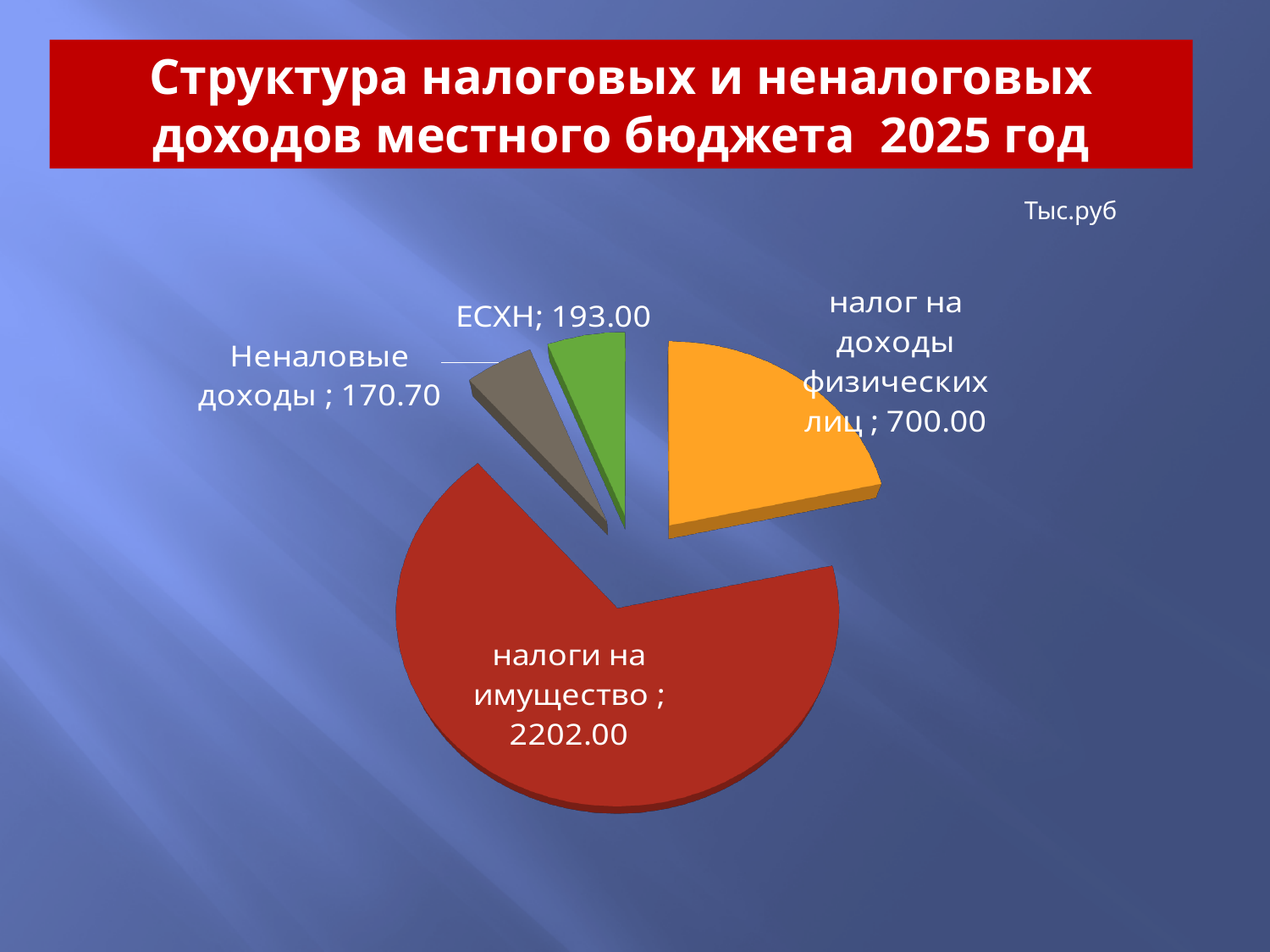
What is the value shown for Неналовые доходы? 170.70 Which category has the largest slice of the pie? налоги на имущество How many slices does the pie chart have? 4 What unit is indicated for the chart values? Тыс.руб What is the difference between ЕСХН and Неналовые доходы? 22.30 Which category has the smallest slice of the pie? Неналовые доходы Which is larger, ЕСХН or Неналовые доходы? ЕСХН What is the value shown for налог на доходы физических лиц? 700.00 What is the difference between налоги на имущество and налог на доходы физических лиц? 1502.00 What kind of chart is shown on the slide? pie chart What is the value of the ЕСХН slice? 193.00 What is the value of the налоги на имущество slice? 2202.00